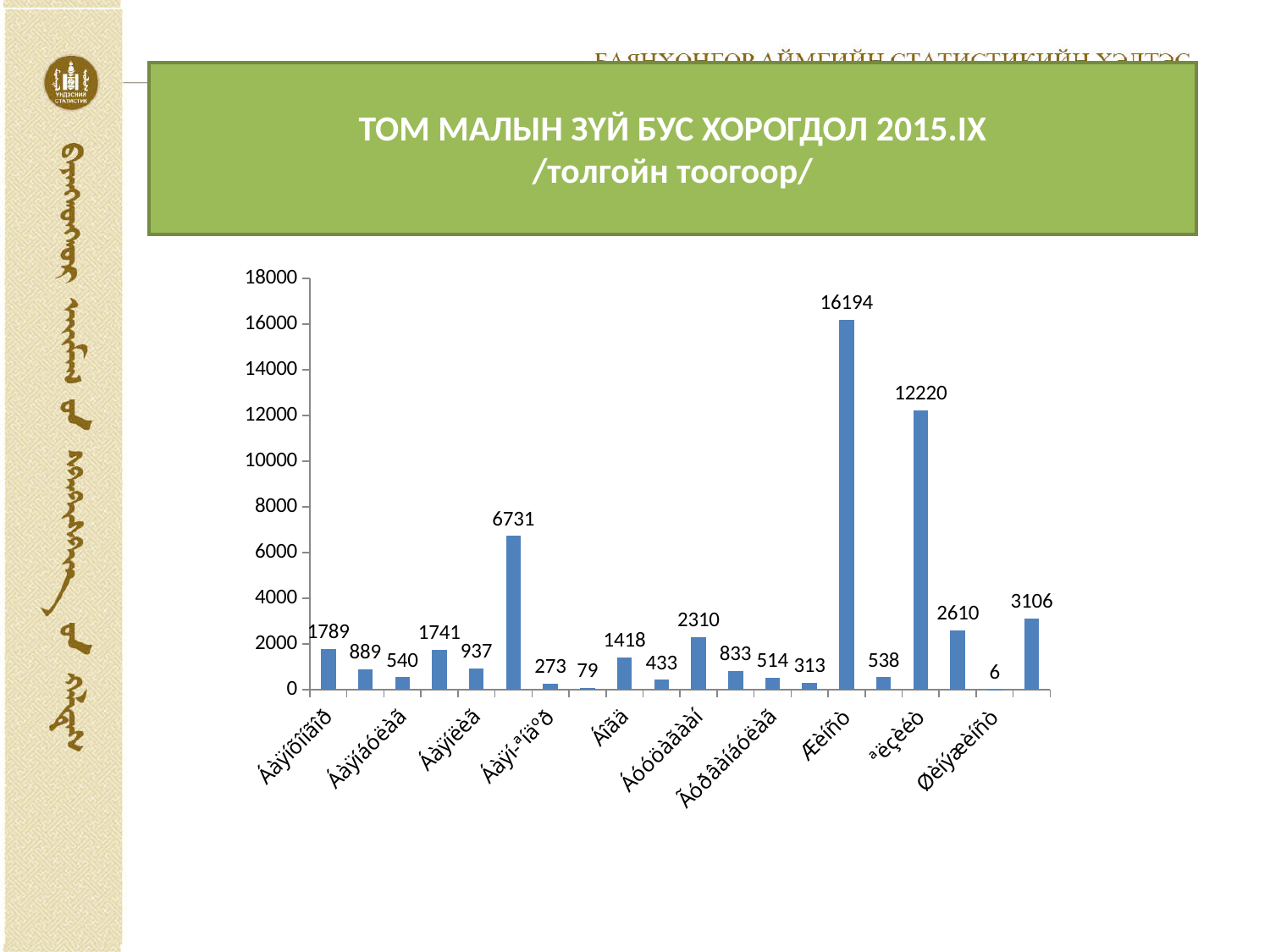
What period does the chart title refer to? 2015.IX What is the difference between the two tallest bars (16194 and 12220)? 3974 What kind of chart is shown on the slide? bar chart What is the value of the second-highest bar on the chart? 12220 What is the lowest value shown on the chart? 6 What is the highest value shown on the chart? 16194 Which is larger: the sixth bar (6731) or the eleventh bar (2310)? 6731 Is the value of the tallest bar greater or less than 14000? greater What is the value of the last (rightmost) bar on the chart? 3106 What is the value of the first (leftmost) bar on the chart? 1789 What is the maximum value shown on the vertical axis? 18000 How many bars are plotted on the chart? 20